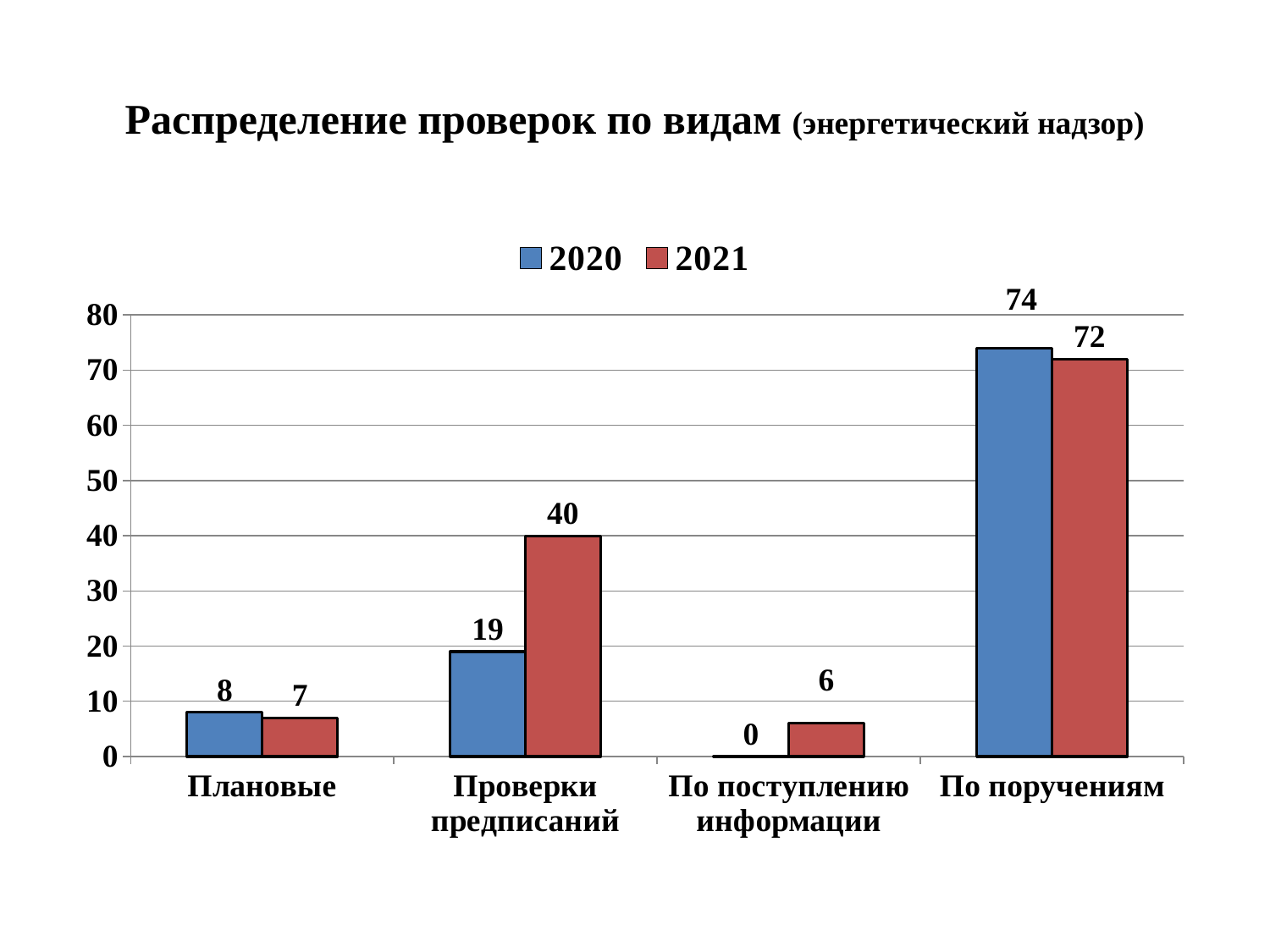
Is the 2021 value for 'По поручениям' greater or less than 50? greater What kind of chart is shown on the slide? bar chart Which is larger for 'Плановые': the 2020 value or the 2021 value? 2020 What is the value for 2021 in the 'Проверки предписаний' category? 40 Which category has the lowest value for 2020? По поступлению информации What is the value for 2020 in the 'По поступлению информации' category? 0 What is the difference between the 2020 and 2021 values for 'По поручениям'? 2 Which category has the highest value for 2021? По поручениям What is the difference between the 2021 and 2020 values for 'Проверки предписаний'? 21 How many categories are shown on the x axis? 4 What is the value for 2020 in the 'По поручениям' category? 74 How many series does the legend list? 2